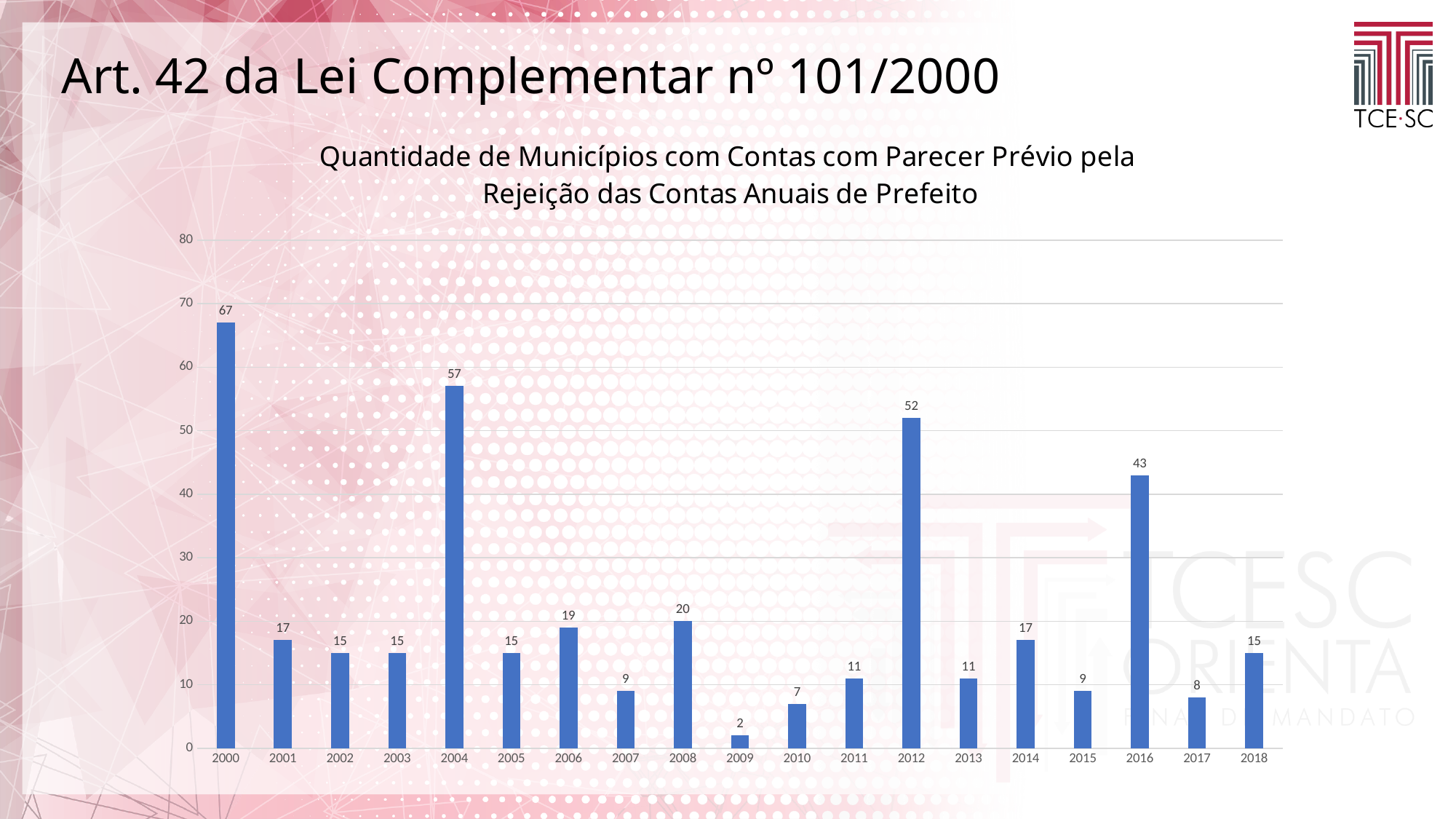
What is the title of the chart? Quantidade de Municípios com Contas com Parecer Prévio pela Rejeição das Contas Anuais de Prefeito What is the value for 2004? 57 Which is larger, the value for 2008 or the value for 2006? 2008 What is the value for 2009? 2 Which year has the highest value? 2000 What is the difference between the values for 2016 and 2018? 28 What is the value for 2012? 52 Which year has the lowest value? 2009 How many years are shown on the x axis? 19 Is the value for 2012 greater or less than 50? greater What kind of chart is shown on the slide? bar chart What is the difference between the values for 2000 and 2004? 10